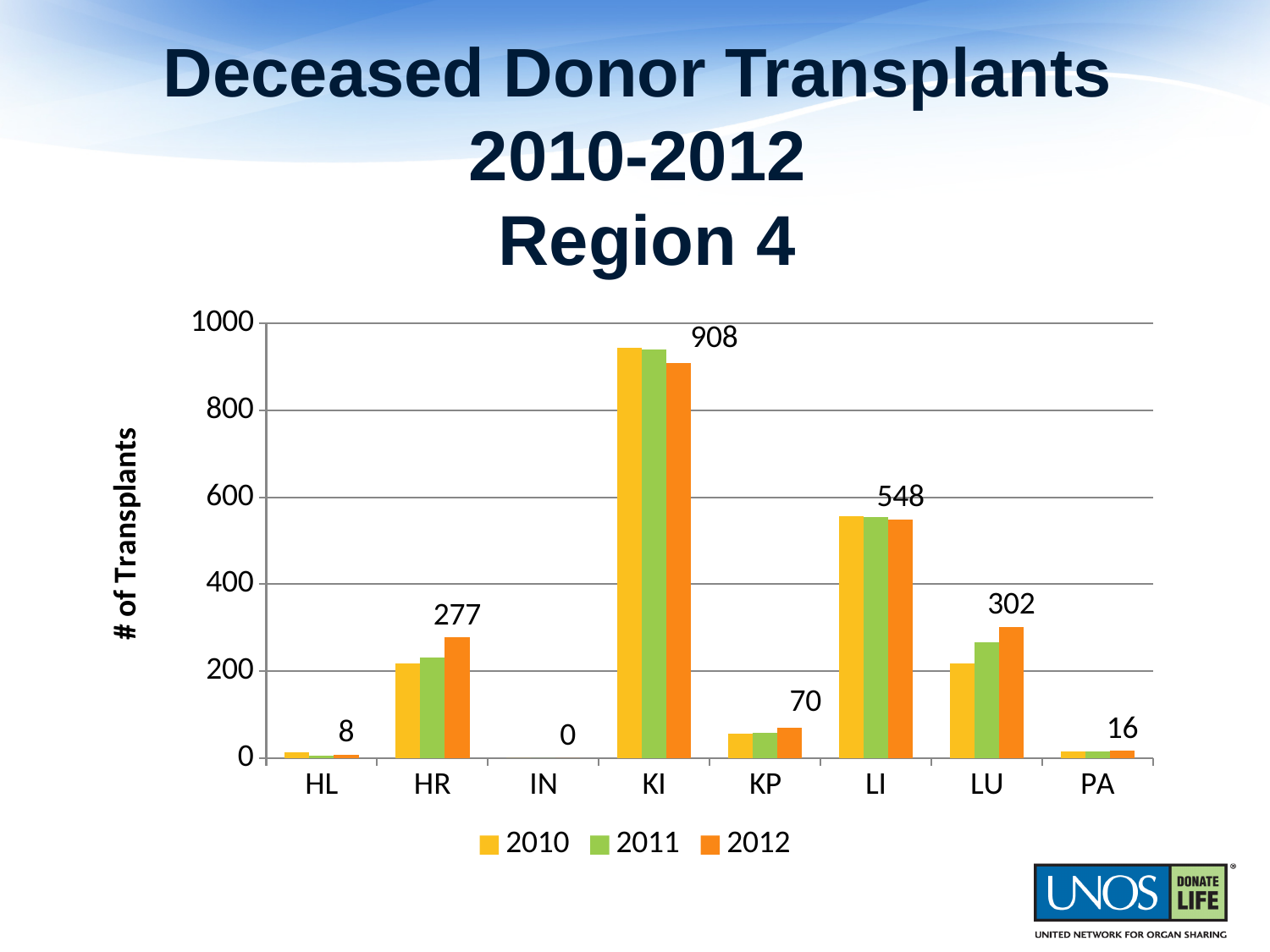
What kind of chart is shown on the slide? bar chart How many series does the legend list? 3 Which category has the highest 2012 value? KI What is the 2012 value for PA? 16 What is the 2012 value for HR? 277 Which category has the lowest 2012 value? IN What is the 2012 value for LU? 302 What is the 2012 value for KI? 908 What is the difference between the 2012 values for KI and LI? 360 How many categories are shown on the x axis? 8 Is the 2010 value for KI greater or less than 800? greater Which is larger, the 2012 value for KP or the 2012 value for PA? KP